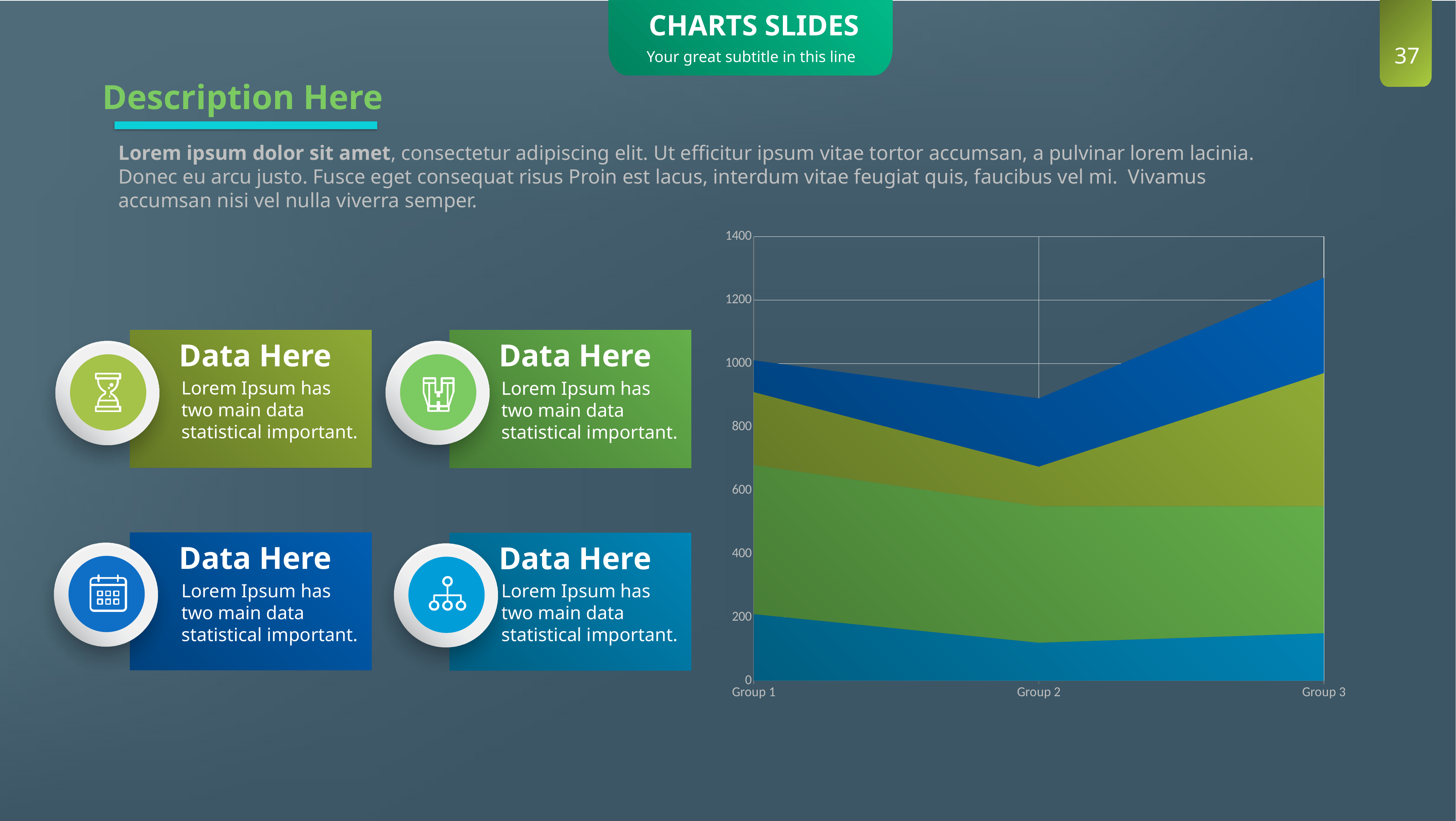
Is the total stacked value for Group 3 greater or less than 1200? greater Which has the larger total stacked value, Group 1 or Group 3? Group 3 What kind of chart is shown on the slide? Area chart What are the category labels on the x axis of the chart? Group 1, Group 2, Group 3 How many stacked series (coloured bands) does the chart show? 4 Does the total stacked value rise or fall from Group 1 to Group 2? fall Which category has the lowest total stacked value? Group 2 What is the highest value shown on the chart's y axis? 1400 How many categories are shown on the x axis of the chart? 3 Is the total stacked value for Group 2 greater or less than 1000? less Does the total stacked value rise or fall from Group 2 to Group 3? rise Which category has the highest total stacked value? Group 3